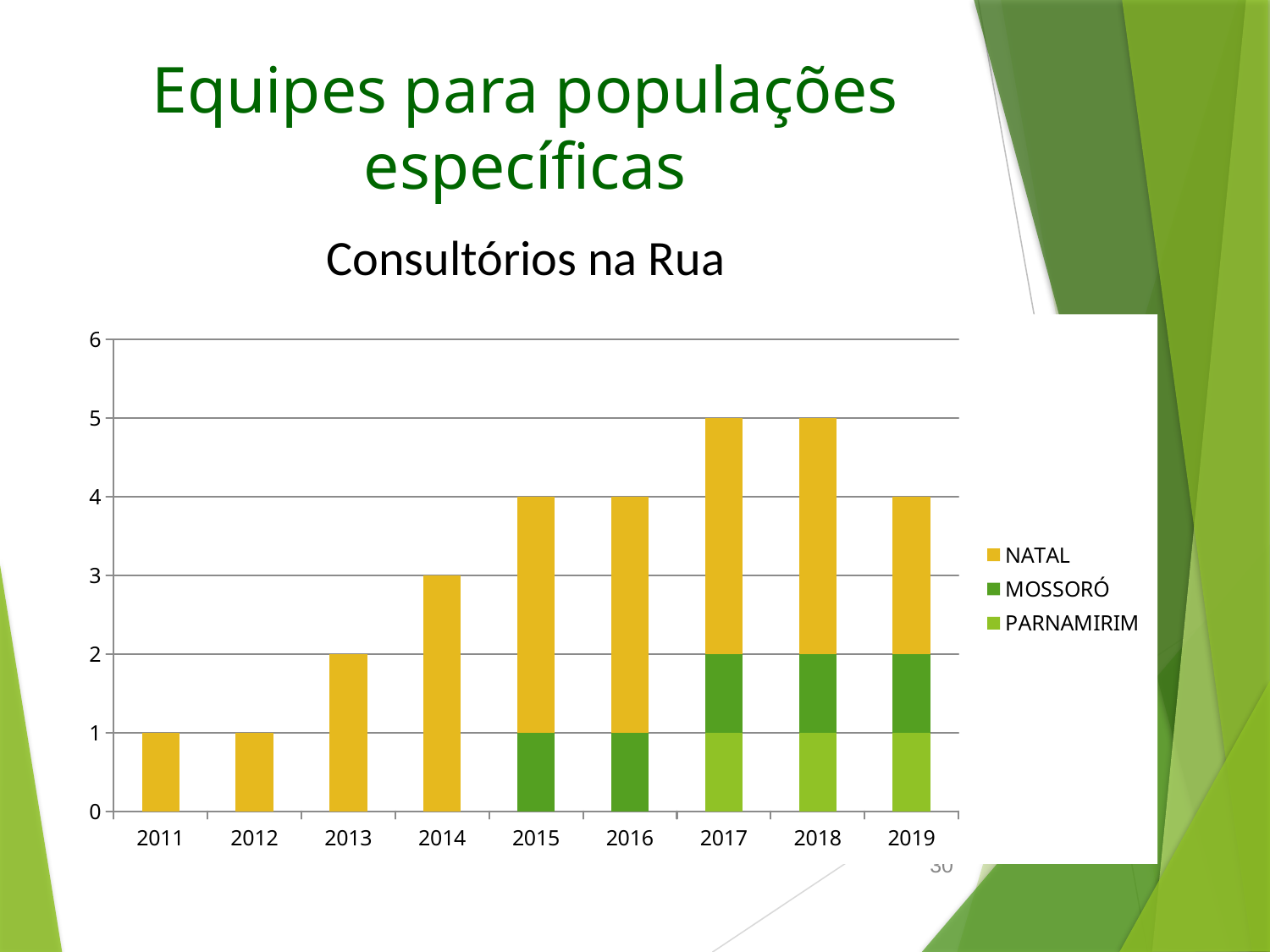
Which years have the highest total bar? 2017 and 2018 How many series does the legend list? 3 Is the total bar for 2018 larger than the total bar for 2019? Yes What kind of chart is shown on the slide? Stacked bar chart What is the difference between the total bar for 2017 and the total bar for 2013? 3 How many years are shown on the x axis? 9 What is the total height of the stacked bar for 2014? 3 What is the title of the chart? Consultórios na Rua What is the total height of the stacked bar for 2017? 5 Which years have the lowest total bar? 2011 and 2012 What is the total height of the stacked bar for 2019? 4 In which year does the PARNAMIRIM series first appear in the chart? 2017